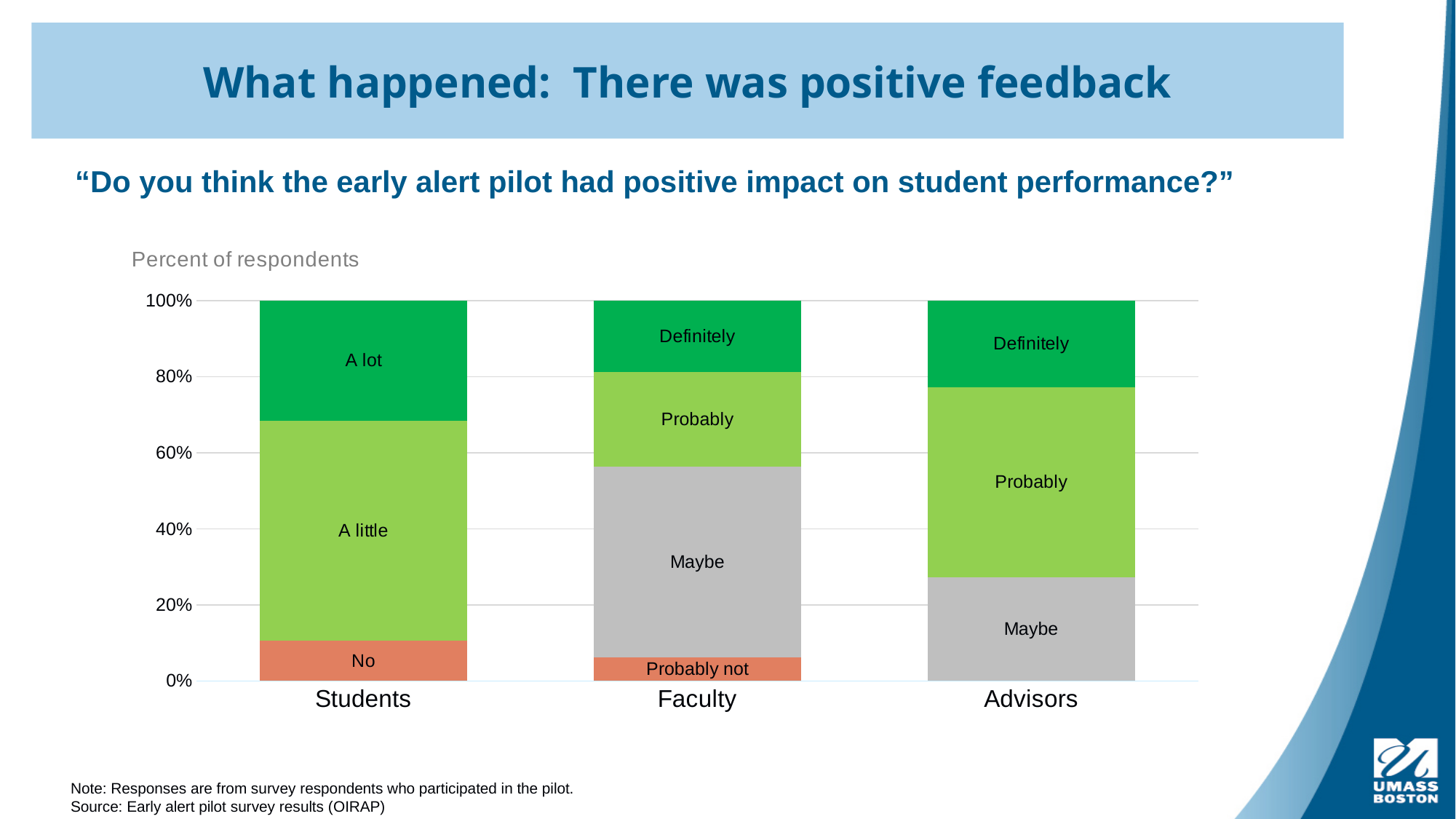
How many respondent groups are shown along the x axis of the chart? 3 Which group has a larger "Probably" share of respondents, Faculty or Advisors? Advisors Which group has a larger "Maybe" share of respondents, Faculty or Advisors? Faculty Is the "Probably" segment for Advisors greater or less than 40% of respondents? greater What kind of chart is shown on the slide? Stacked bar chart Is the "Maybe" segment for Faculty greater or less than 40% of respondents? greater Is the "No" segment for Students greater or less than 20% of respondents? less What is the label shown above the y axis of the chart? Percent of respondents Which group's bar has no negative response segment (no "No" or "Probably not")? Advisors What is the total height of the Students bar? 100%